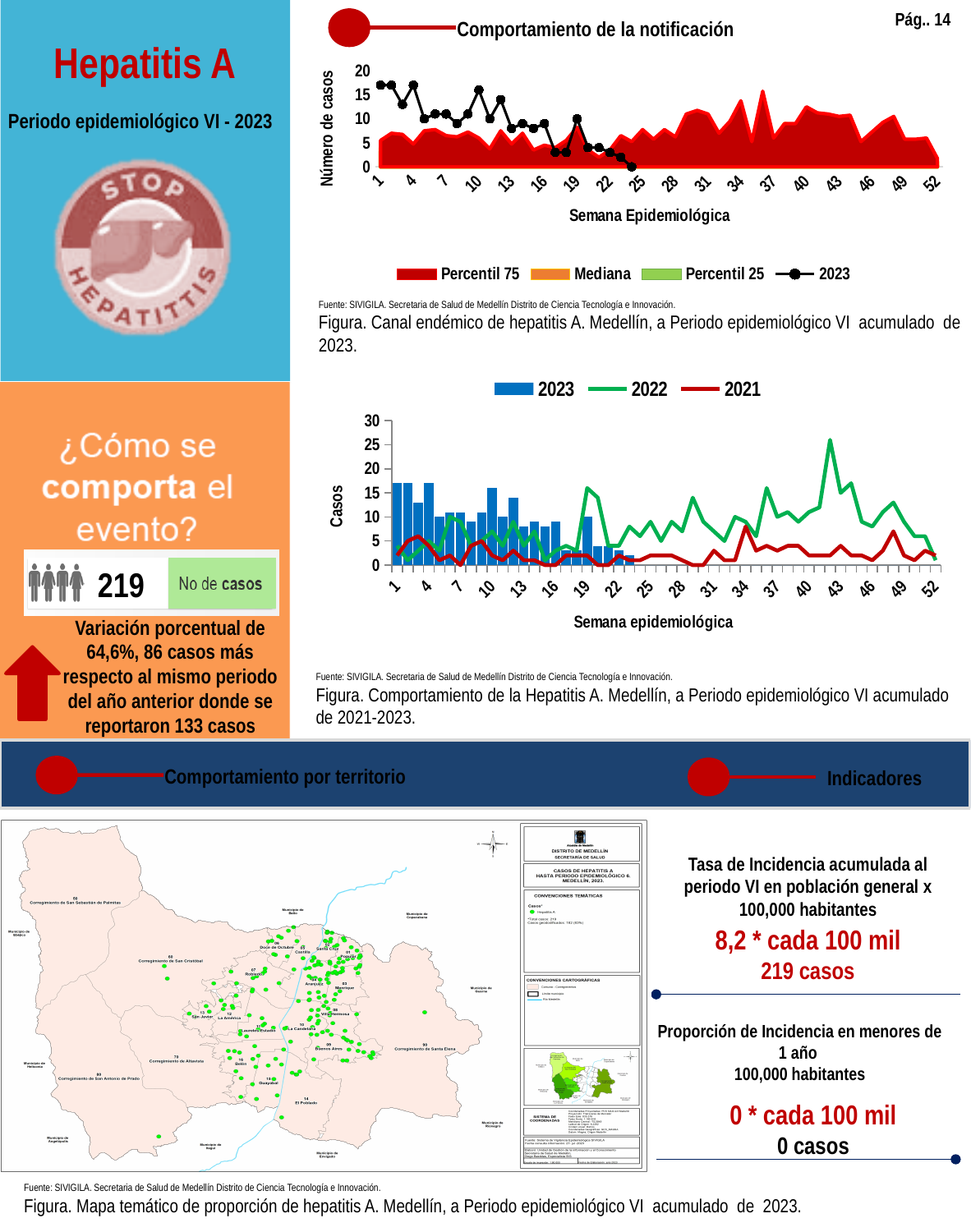
In the top chart (Canal endémico de hepatitis A), is the 2023 value at week 24 greater or less than 5? less In the bottom chart (Comportamiento de la Hepatitis A, 2021-2023), which series is drawn as bars rather than a line? 2023 In the bottom chart (Comportamiento de la Hepatitis A, 2021-2023), which series is higher at week 42: 2022 or 2021? 2022 In the bottom chart (Comportamiento de la Hepatitis A, 2021-2023), which series reaches the highest peak? 2022 In the bottom chart (Comportamiento de la Hepatitis A, 2021-2023), how many series does the legend list? 3 In the top chart (Canal endémico de hepatitis A), is the 2023 value at week 1 greater or less than 15? greater In the top chart (Canal endémico de hepatitis A), how many series does the legend list? 4 In the bottom chart (Comportamiento de la Hepatitis A, 2021-2023), is the 2022 peak around week 42 greater or less than 20? greater In the top chart (Canal endémico de hepatitis A), does the 2023 line rise or fall from week 1 to week 24? fall In the top chart (Canal endémico de hepatitis A), what is the label of the y axis? Número de casos